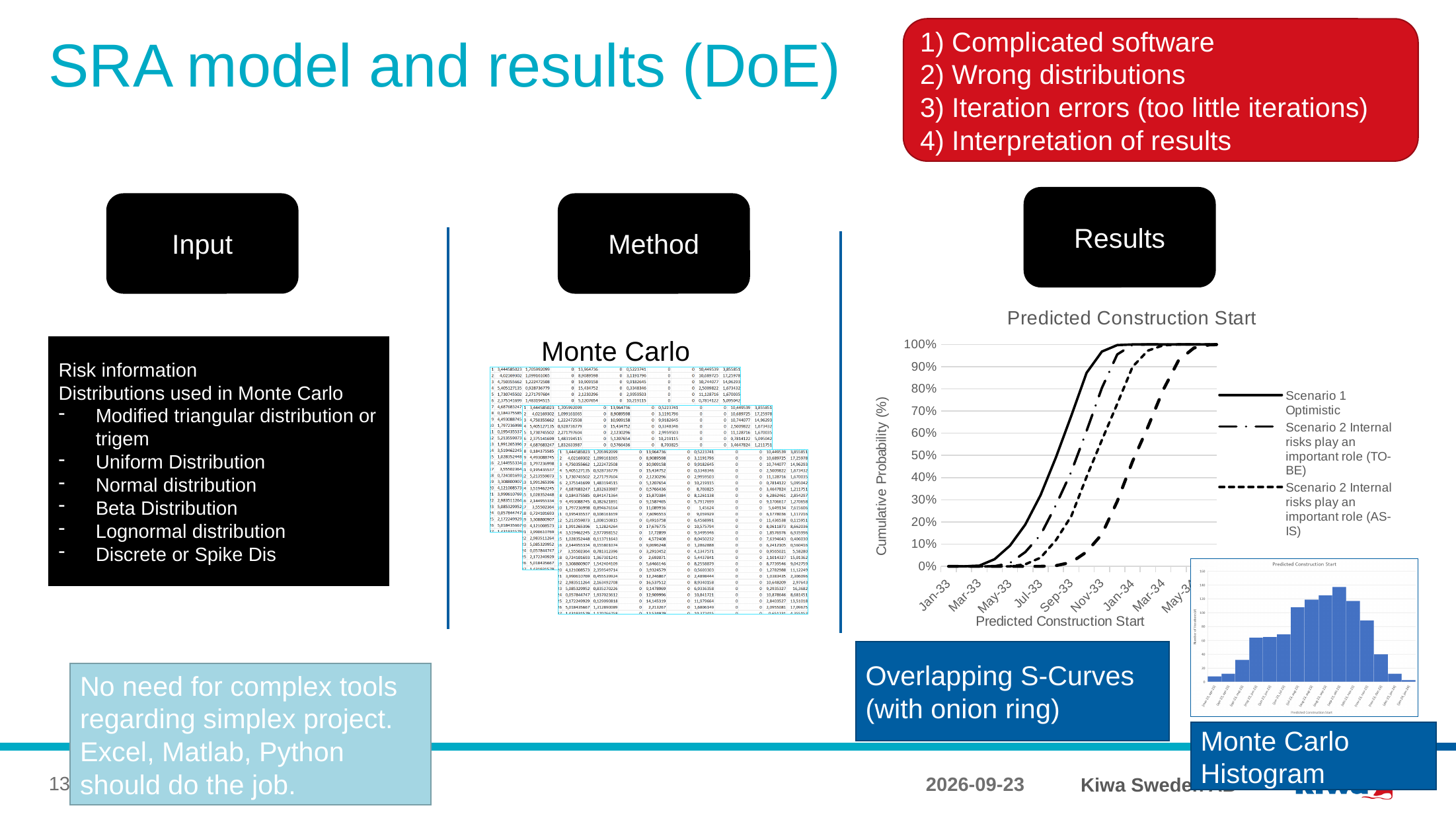
In the 'Predicted Construction Start' line chart, which series reaches 100% cumulative probability first (earliest along the x axis)? Scenario 1 Optimistic What kind of chart is the 'Predicted Construction Start' chart on the right of the slide? Line chart How many series does the legend of the 'Predicted Construction Start' line chart list? 3 What is the y-axis label of the 'Predicted Construction Start' line chart? Cumulative Probability (%) In the 'Predicted Construction Start' line chart, is the value for Scenario 1 Optimistic at Jan-33 greater or less than 50%? less What is the highest value shown on the y axis of the 'Predicted Construction Start' line chart? 100% In the 'Predicted Construction Start' line chart, is the value for Scenario 1 Optimistic at May-34 greater or less than 50%? greater In the 'Predicted Construction Start' line chart, is the value for Scenario 2 Internal risks play an important role (AS-IS) at Mar-33 greater or less than 10%? less What is the title of the line chart in the Results section? Predicted Construction Start In the 'Predicted Construction Start' line chart, do the curves rise or fall as the x axis moves from Jan-33 to May-34? Rise